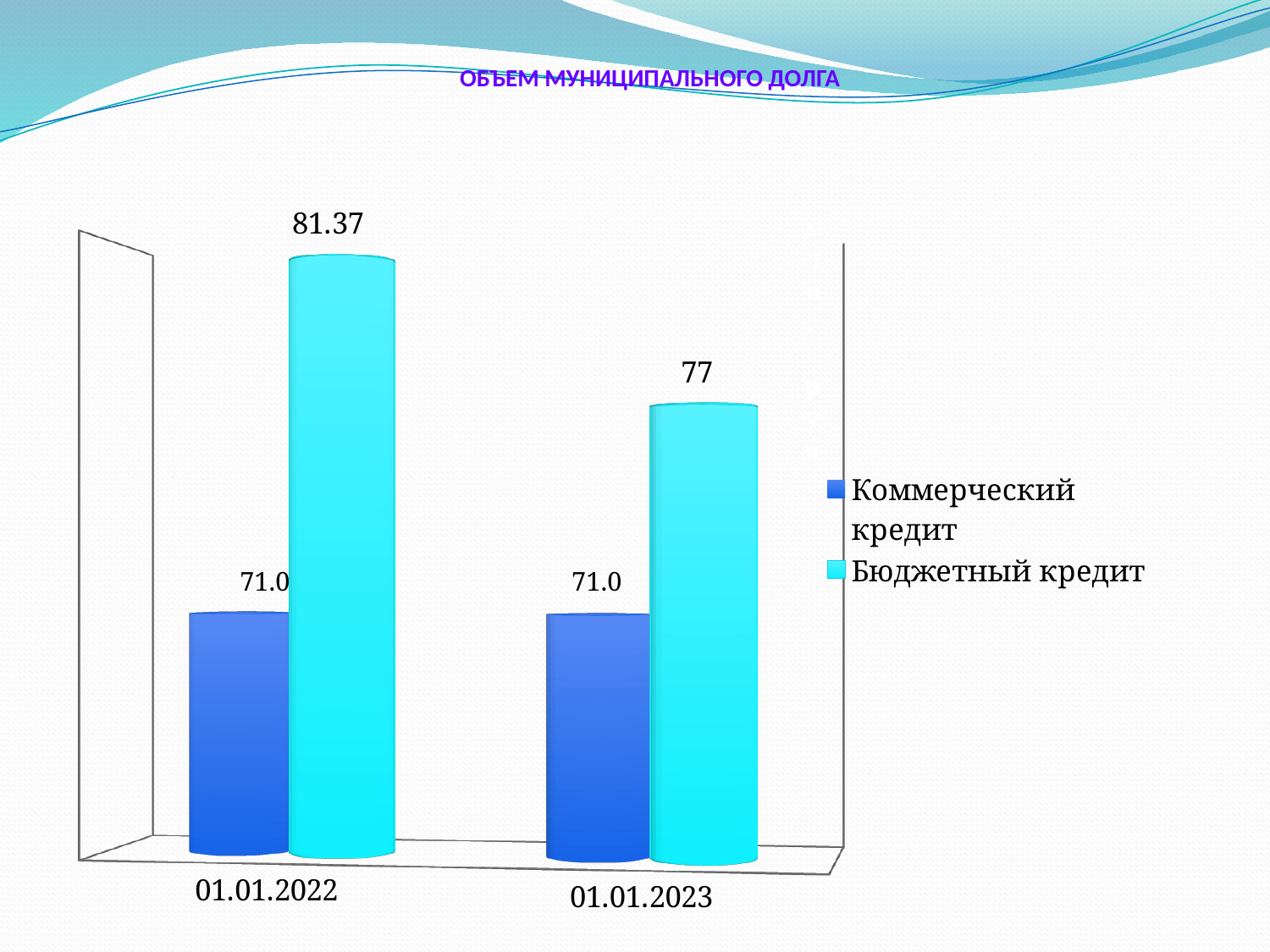
What is the value of Коммерческий кредит on 01.01.2022? 71.0 What is the value of Коммерческий кредит on 01.01.2023? 71.0 What is the value of Бюджетный кредит on 01.01.2023? 77 Which series has the highest value on 01.01.2022? Бюджетный кредит What is the value of Бюджетный кредит on 01.01.2022? 81.37 Which is larger: Бюджетный кредит on 01.01.2022 or Бюджетный кредит on 01.01.2023? 01.01.2022 How many categories are shown on the x axis? 2 What is the difference between Бюджетный кредит on 01.01.2022 and on 01.01.2023? 4.37 How many series does the legend list? 2 What kind of chart is shown on the slide? Bar chart Which series has the lowest value on 01.01.2023? Коммерческий кредит What is the title of the chart? ОБЪЕМ МУНИЦИПАЛЬНОГО ДОЛГА